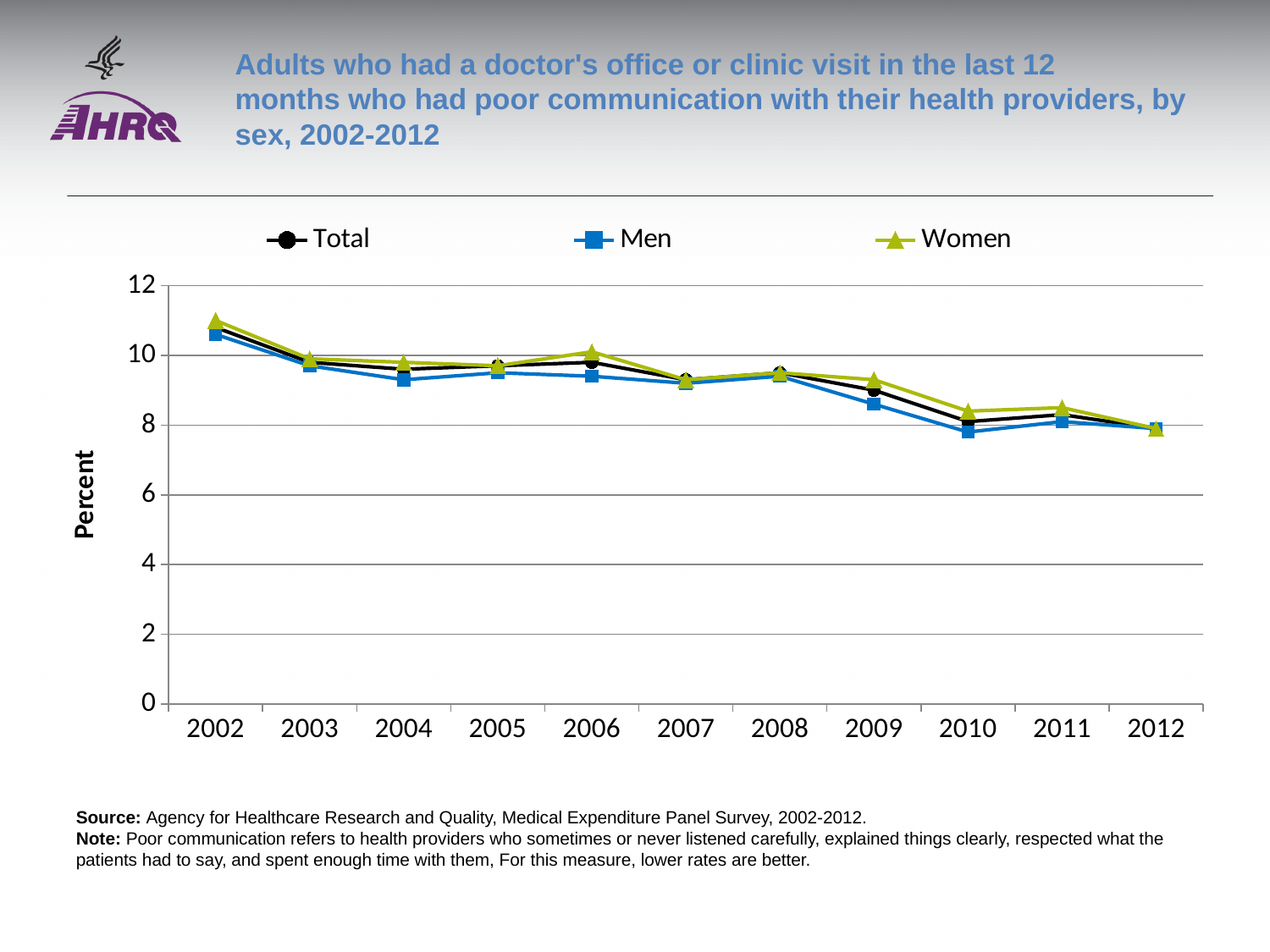
How many years are plotted along the x axis? 11 What kind of chart is shown on the slide? Line chart Is the value for Men in 2004 greater or less than 10? less For the Total series, which is larger, the value in 2002 or the value in 2012? 2002 Is the value for Women in 2010 greater or less than 8? greater What is the label on the y axis? Percent In 2009, which is larger, the value for Men or the value for Women? Women In which year is the value for Women highest? 2002 Do the values for Total generally rise or fall from 2002 to 2012? Fall How many series does the legend list? 3 Is the value for Men in 2010 greater or less than 8? less